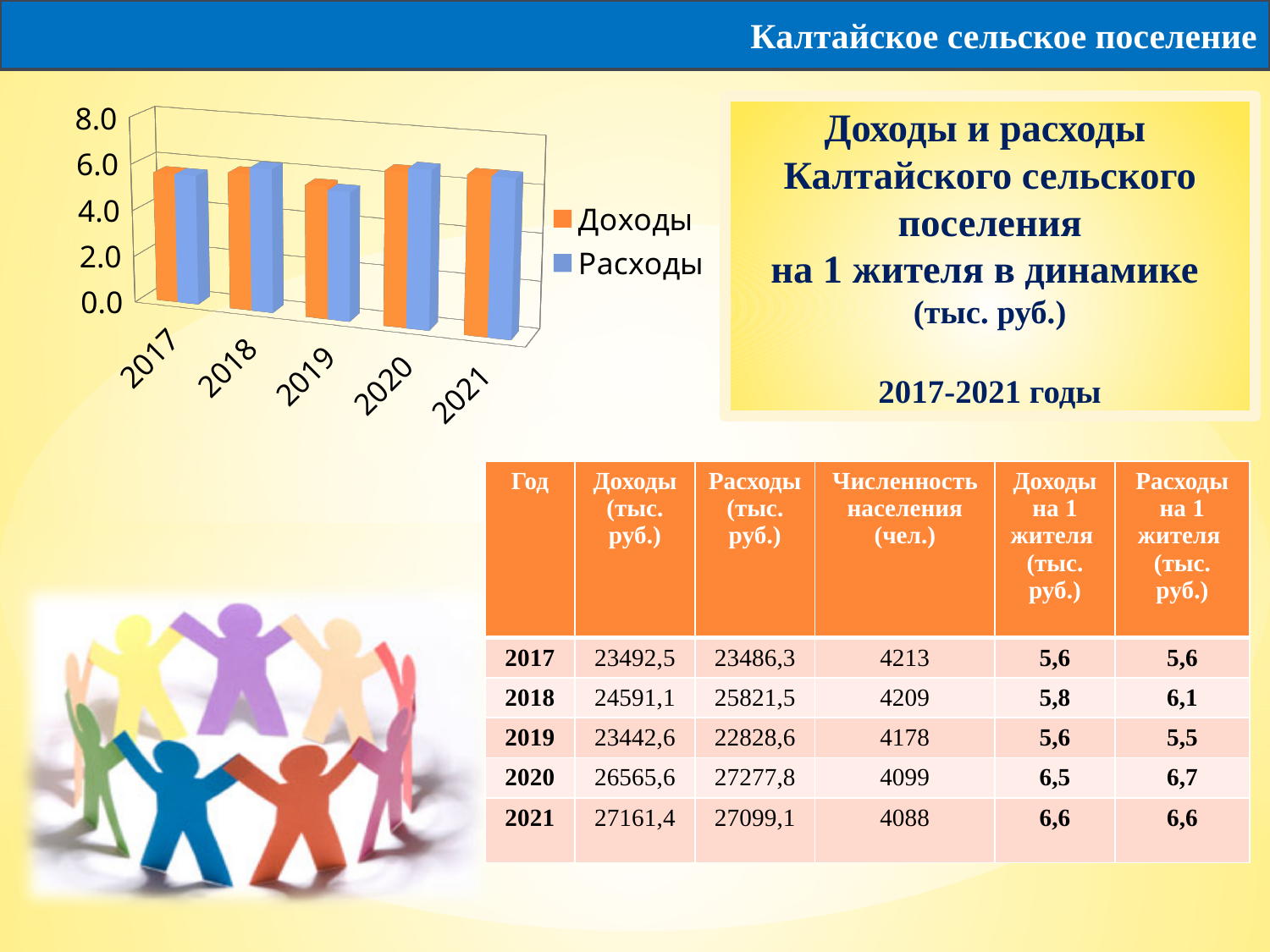
Is the Доходы value for 2019 greater or less than 6.0? less What is the value of Доходы per resident for 2018 (тыс. руб.)? 5,8 How many series does the chart legend list? 2 What are the two series named in the chart legend? Доходы and Расходы In which year is the Расходы bar the lowest? 2019 In 2018, which is larger: Доходы or Расходы? Расходы Do the Доходы values in 2021 rise or fall compared with 2017? rise What is the difference between Расходы and Доходы per resident in 2018 (тыс. руб.)? 0,3 What kind of chart is shown on the slide? bar chart How many years are shown along the x axis of the chart? 5 Which colour represents Расходы in the chart? blue What is the value of Расходы per resident for 2020 (тыс. руб.)? 6,7